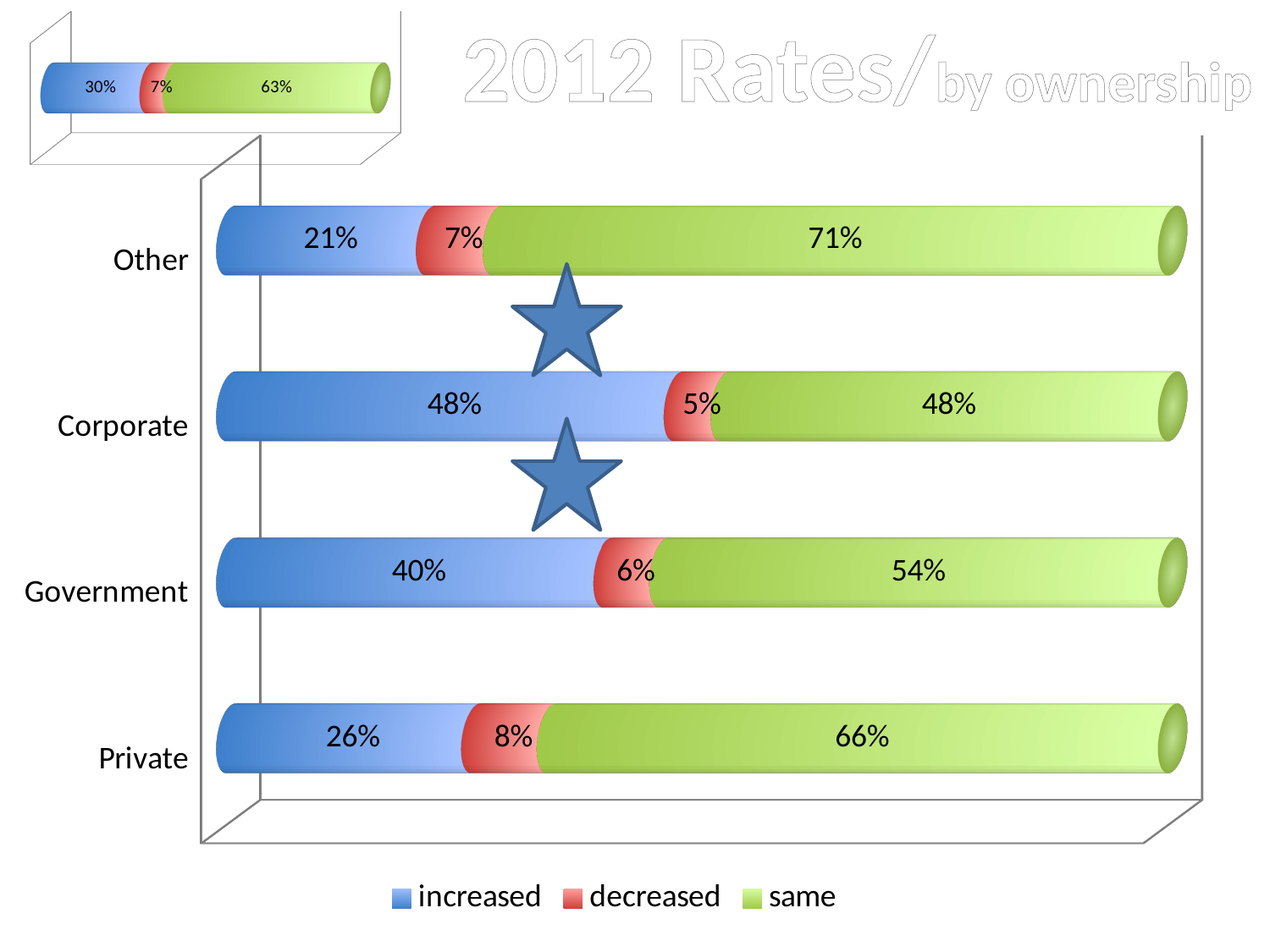
How many series does the legend of the main chart list? 3 In the main chart, what is the 'same' value for Other? 71% In the main chart, which ownership category has the lowest 'decreased' value? Corporate In the main chart, what is the 'increased' value for Government? 40% How many ownership categories are shown in the main chart? 4 In the main chart, which ownership category has the highest 'increased' value? Corporate In the main chart, which is larger: the 'increased' value for Private or for Other? Private In the small chart at the top left of the slide, what is the 'same' value? 63% In the main chart, what is the 'decreased' value for Private? 8% In the main chart, what percentage of Corporate respondents reported rates increased? 48% In the main chart, what is the difference between the 'same' values for Other and Corporate? 23% What kind of chart is the main chart on the slide? Stacked bar chart